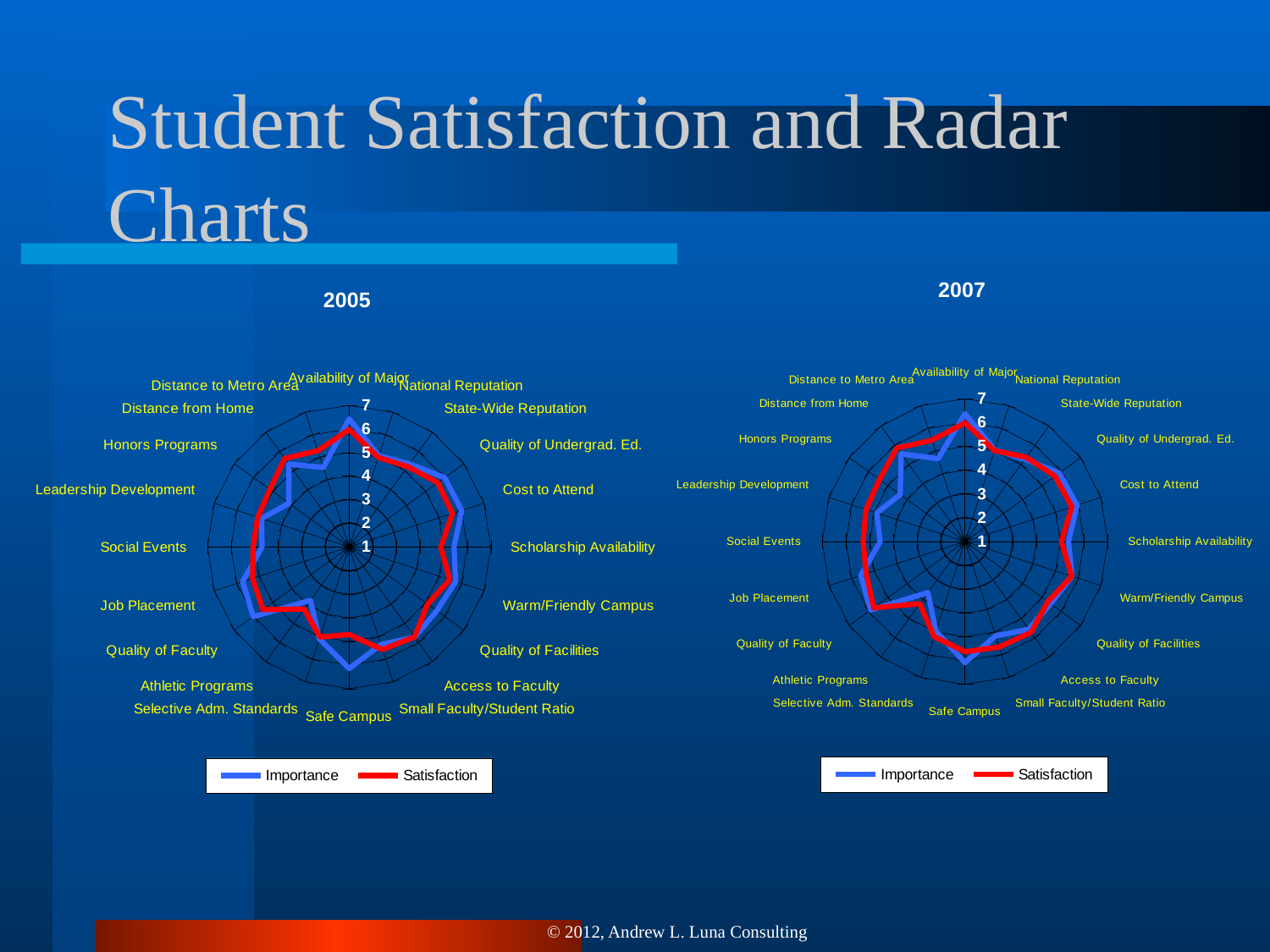
How many charts are shown on the slide? 2 In the 2005 chart, is the Satisfaction value for Athletic Programs greater or less than 5? less In the 2007 chart, is the Satisfaction value for Honors Programs greater or less than 6? less In the 2007 chart, which series is drawn in blue? Importance In the 2005 chart, which series is drawn in red? Satisfaction In the 2007 chart, is the Importance value for Cost to Attend greater or less than 4? greater How many series does the legend of the 2007 chart list? 2 How many categories are plotted around the 2005 radar chart? 20 In the 2005 chart, for Safe Campus, which series has the larger value, Importance or Satisfaction? Importance What is the highest value shown on the axis scale of the 2007 chart? 7 What kind of chart is the 2005 chart? Radar chart